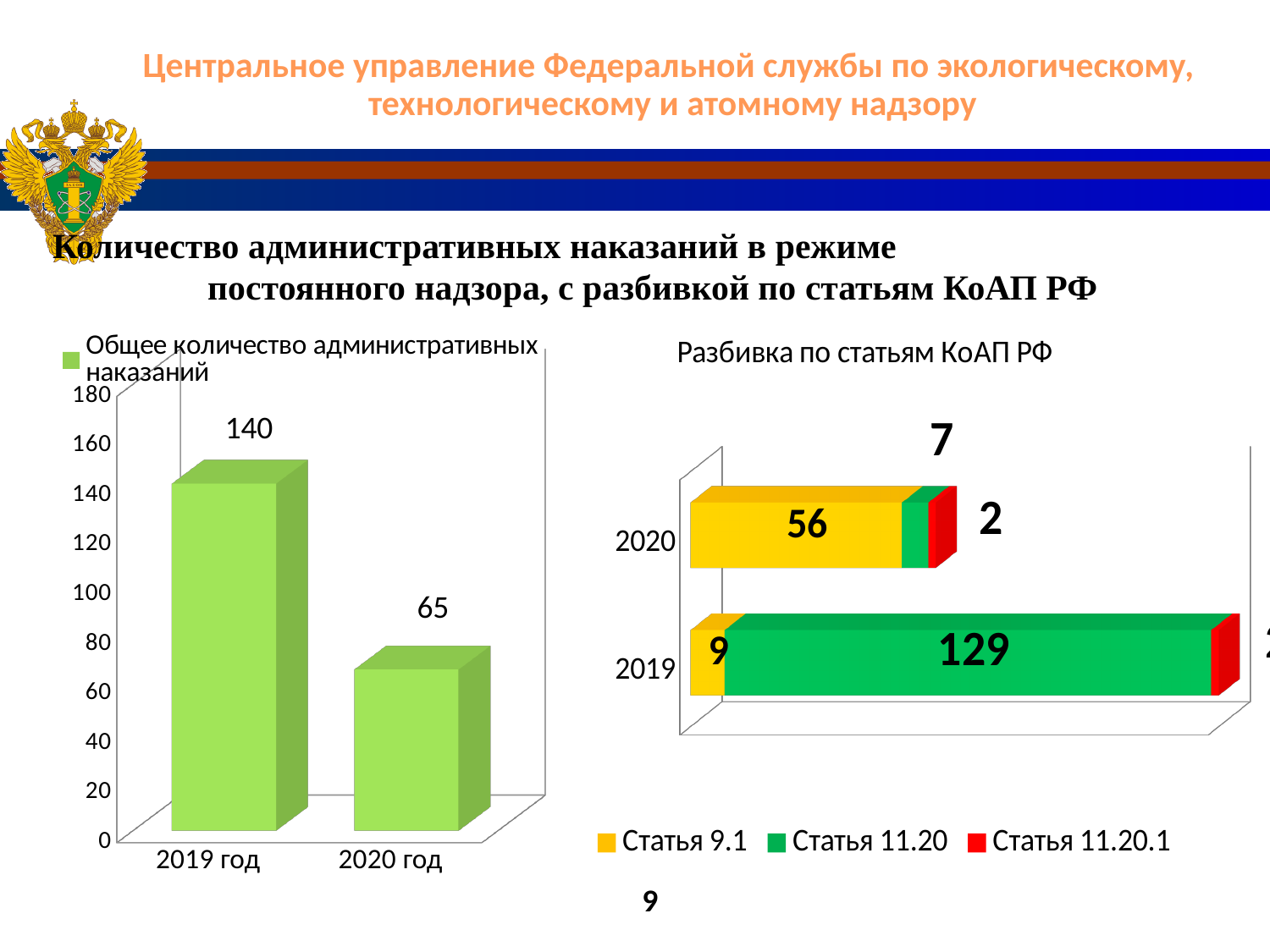
On the left chart (Общее количество административных наказаний), what is the difference between the 2019 год and 2020 год values? 75 On the right chart (Разбивка по статьям КоАП РФ), what is the total of the stacked bar for 2020? 65 On the right chart (Разбивка по статьям КоАП РФ), which series is shown in red in the legend? Статья 11.20.1 On the left chart (Общее количество административных наказаний), what kind of chart is it? bar chart On the left chart (Общее количество административных наказаний), what is the value for 2020 год? 65 On the right chart (Разбивка по статьям КоАП РФ), what is the value for Статья 9.1 in 2020? 56 On the right chart (Разбивка по статьям КоАП РФ), what is the value for Статья 11.20.1 in 2020? 2 On the right chart (Разбивка по статьям КоАП РФ), how many series does the legend list? 3 On the left chart (Общее количество административных наказаний), do the values rise or fall from 2019 год to 2020 год? fall On the left chart (Общее количество административных наказаний), what is the value for 2019 год? 140 On the left chart (Общее количество административных наказаний), which year has the higher value? 2019 год On the right chart (Разбивка по статьям КоАП РФ), what is the value for Статья 11.20 in 2019? 129